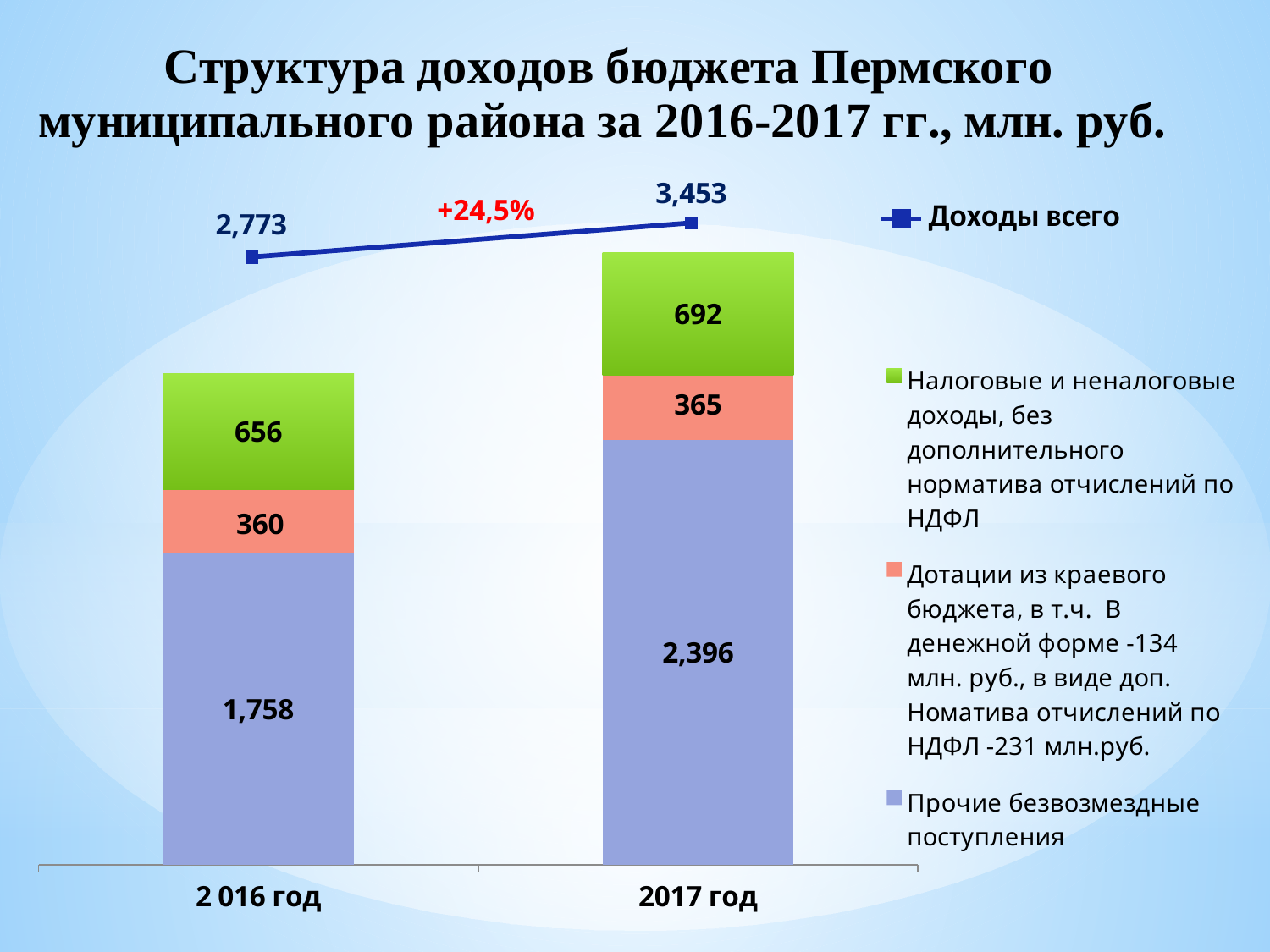
What is the Доходы всего value for 2016 год? 2,773 What percentage change is shown between the 2016 and 2017 totals? +24,5% What is the Доходы всего value for 2017 год? 3,453 What is the value of the green segment (Налоговые и неналоговые доходы) for 2017 год? 692 Which year has the larger Налоговые и неналоговые доходы segment, 2016 год or 2017 год? 2017 год How many entries does the legend list? 4 What is the value of the Прочие безвозмездные поступления segment for 2016 год? 1,758 What kind of chart is this? Stacked bar chart with a line How many years (categories) are shown on the x axis? 2 Which segment is the largest in the 2017 год bar? Прочие безвозмездные поступления By how much did the Прочие безвозмездные поступления segment increase from 2016 год to 2017 год? 638 What is the value of Дотации из краевого бюджета for 2017 год? 365